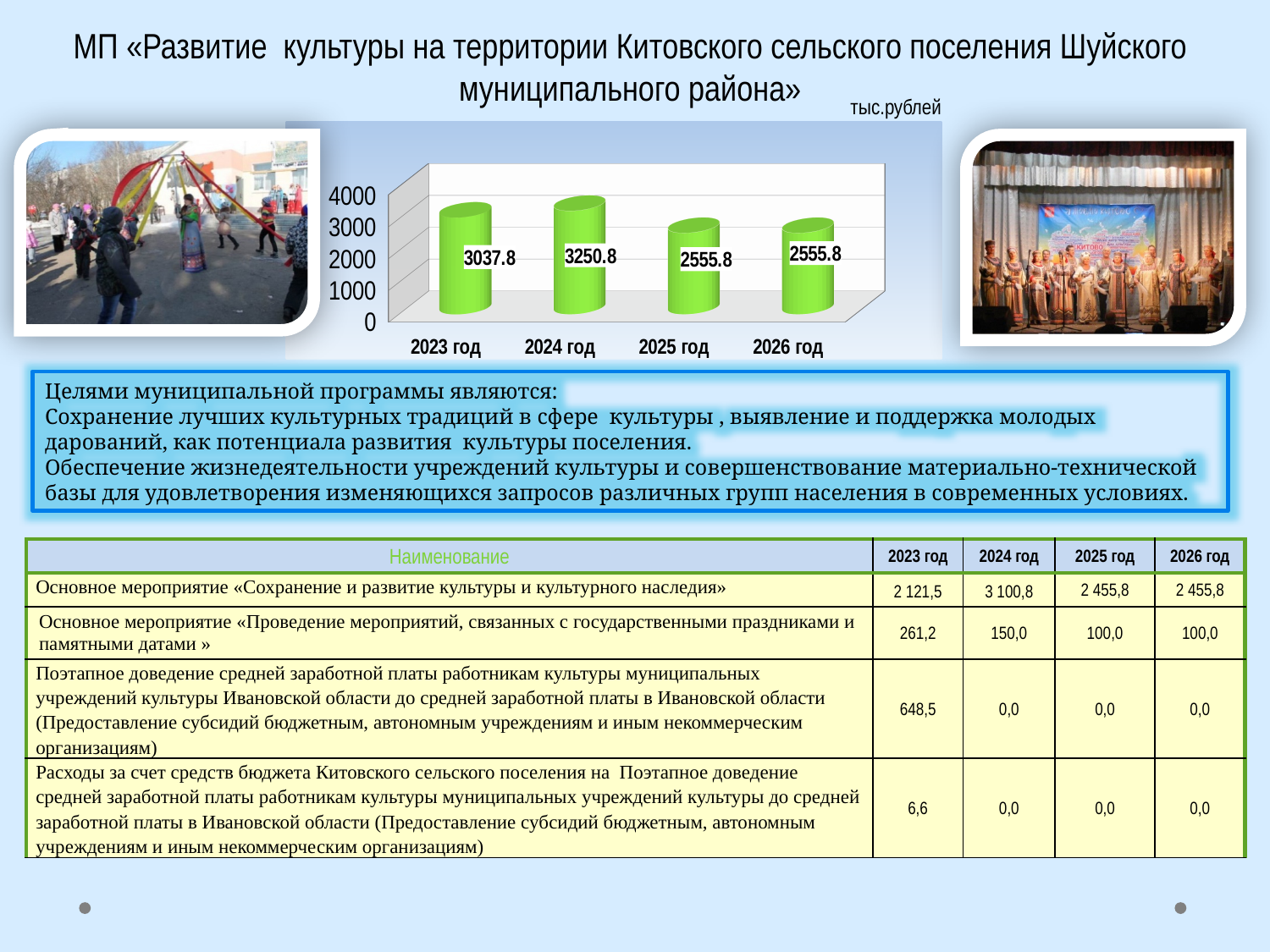
What is the difference between the values for 2024 год and 2025 год? 695.0 What is the difference between the values for 2024 год and 2023 год? 213.0 What kind of chart is shown on the slide? bar chart What is the value for 2024 год on the chart? 3250.8 Which is larger, the value for 2023 год or the value for 2024 год? 2024 год Is the value for 2025 год greater or less than 3000? less How many years are shown on the chart? 4 What is the value for 2025 год on the chart? 2555.8 What is the value for 2023 год on the chart? 3037.8 What is the value for 2026 год on the chart? 2555.8 Which year has the highest value on the chart? 2024 год What unit is indicated above the chart? тыс.рублей